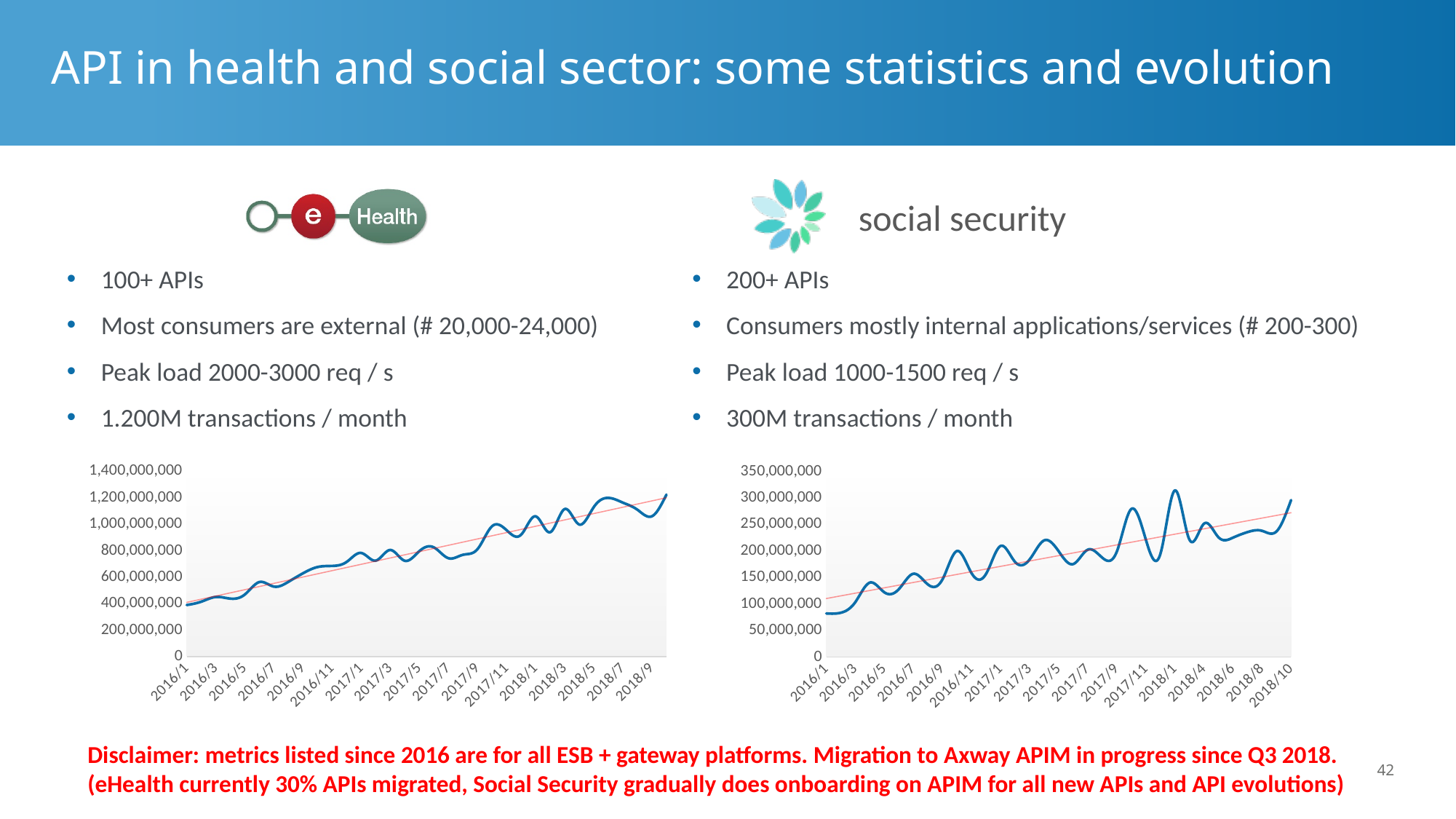
In the left chart (eHealth), is the value at 2018/9 greater or less than 1,000,000,000? greater In the right chart (social security), is the value at 2016/1 greater or less than 100,000,000? less In the left chart (eHealth), do the values generally rise or fall from 2016/1 to 2018/9? rise What kind of chart is the left chart (under the eHealth logo)? line chart In the right chart (social security), is the value at 2018/10 greater or less than 250,000,000? greater What kind of chart is the right chart (under the social security logo)? line chart In the right chart (social security), do the values generally rise or fall from 2016/1 to 2018/10? rise In the right chart (social security), what is the last label on the x-axis? 2018/10 What is the highest value shown on the y-axis of the right chart (social security)? 350,000,000 What is the highest value shown on the y-axis of the left chart (eHealth)? 1,400,000,000